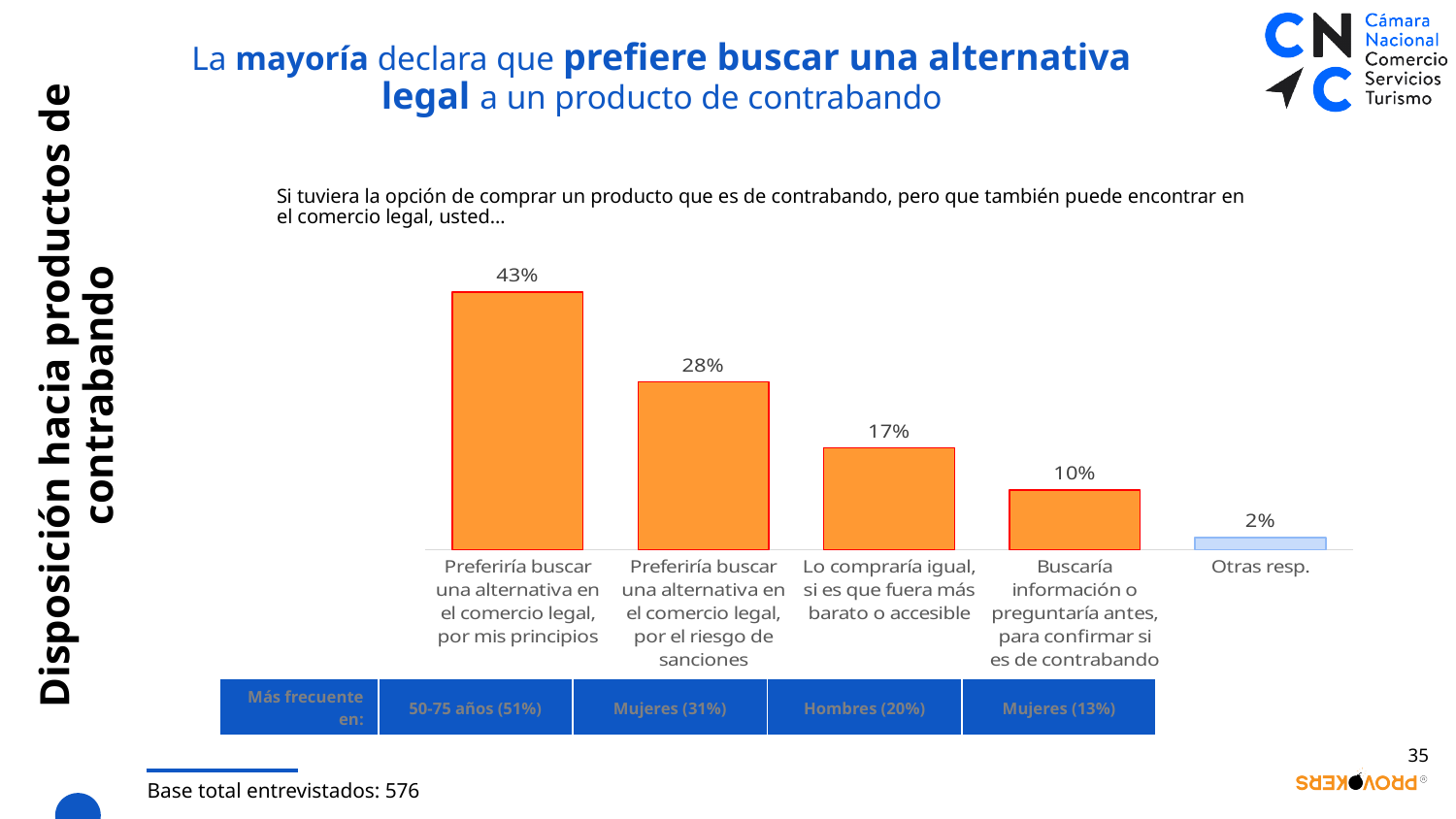
What percentage of respondents said they would prefer to look for a legal alternative because of their principles ("Preferiría buscar una alternativa en el comercio legal, por mis principios")? 43% What is the difference between the value for "por mis principios" and the value for "por el riesgo de sanciones"? 15% What kind of chart is shown on the slide? Bar chart Which category has the highest value? Preferiría buscar una alternativa en el comercio legal, por mis principios Which is larger: the value for "Lo compraría igual, si es que fuera más barato o accesible" or the value for "Buscaría información o preguntaría antes"? Lo compraría igual, si es que fuera más barato o accesible Do the values rise or fall from left to right across the categories? Fall Which category has the lowest value? Otras resp. What is the value for "Buscaría información o preguntaría antes, para confirmar si es de contrabando"? 10% How many categories are shown in the chart? 5 What is the value for "Otras resp."? 2% What is the value for "Preferiría buscar una alternativa en el comercio legal, por el riesgo de sanciones"? 28% What is the value for "Lo compraría igual, si es que fuera más barato o accesible"? 17%